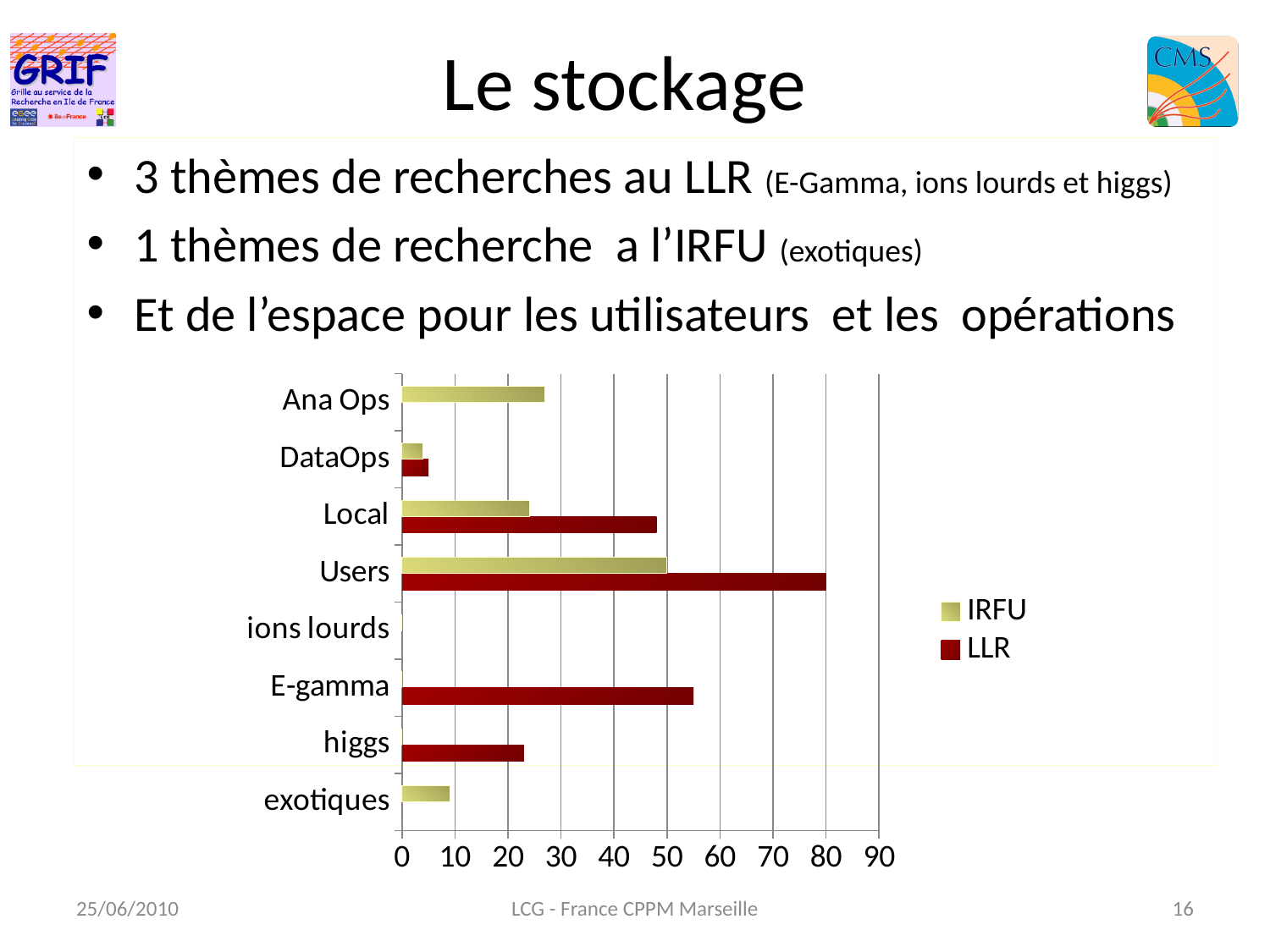
Is the LLR value for Local greater or less than 40? greater How many categories are shown on the vertical axis of the chart? 8 What kind of chart is shown on the slide? bar chart Which category has the highest IRFU value? Users For the Local category, which series has the larger value, IRFU or LLR? LLR What are the two series named in the chart's legend? IRFU and LLR How many series does the chart's legend list? 2 Is the LLR value for E-gamma greater or less than 50? greater Which has the larger LLR value, E-gamma or higgs? E-gamma Is the IRFU value for Ana Ops greater or less than 20? greater Which category has the highest LLR value? Users Among the categories with an LLR bar, which has the lowest LLR value? DataOps